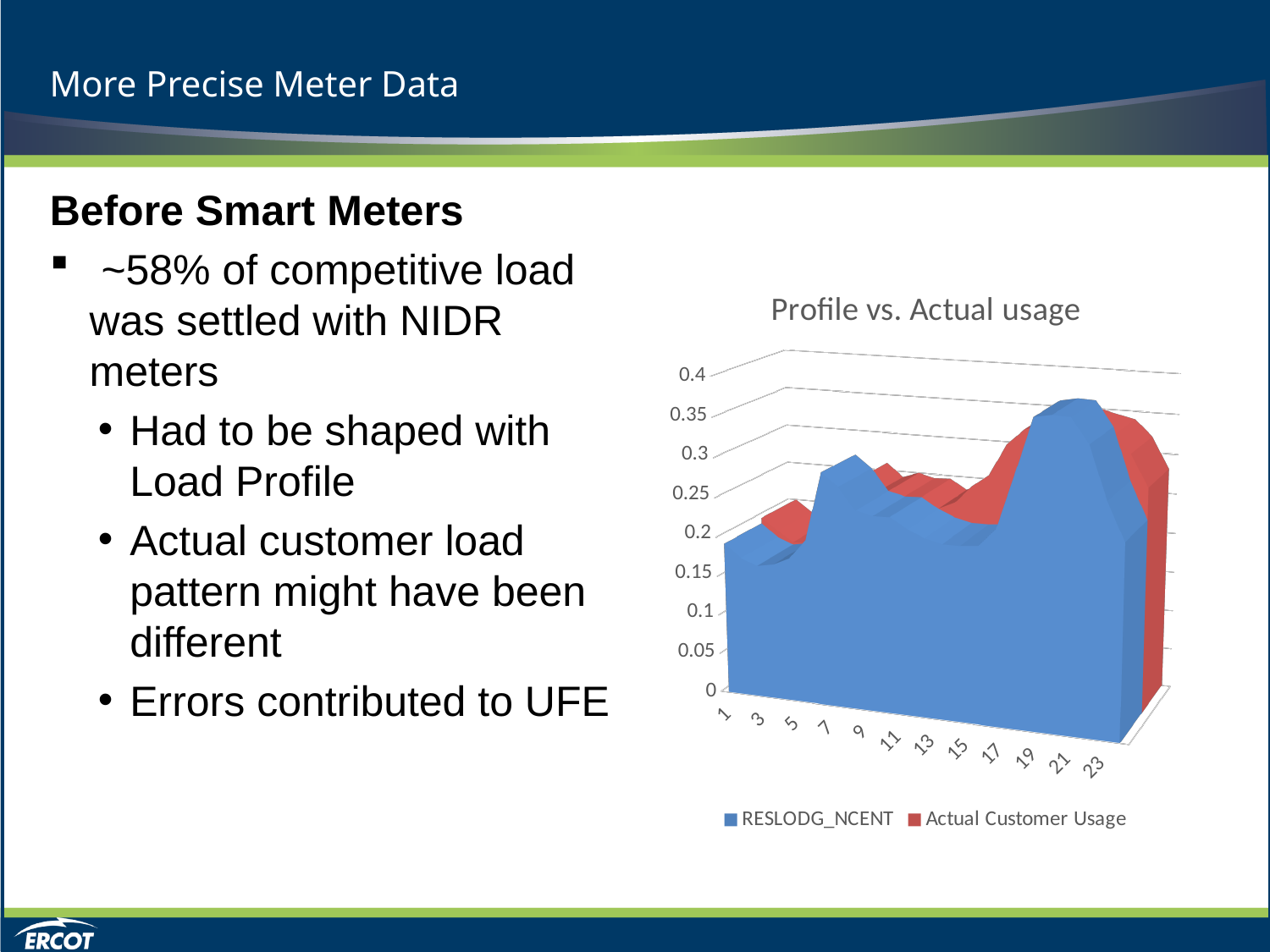
What are the two series named in the chart's legend? RESLODG_NCENT and Actual Customer Usage What is the highest value shown on the chart's vertical axis? 0.4 What is the last label on the chart's horizontal axis? 23 How many labels are shown along the chart's horizontal axis? 12 Do the RESLODG_NCENT values rise or fall between hour 15 and hour 21? rise Is the RESLODG_NCENT value at hour 1 greater or less than 0.25? less What kind of chart is shown on the slide? Area chart How many series does the chart's legend list? 2 Is the peak value of the RESLODG_NCENT series greater or less than 0.3? greater